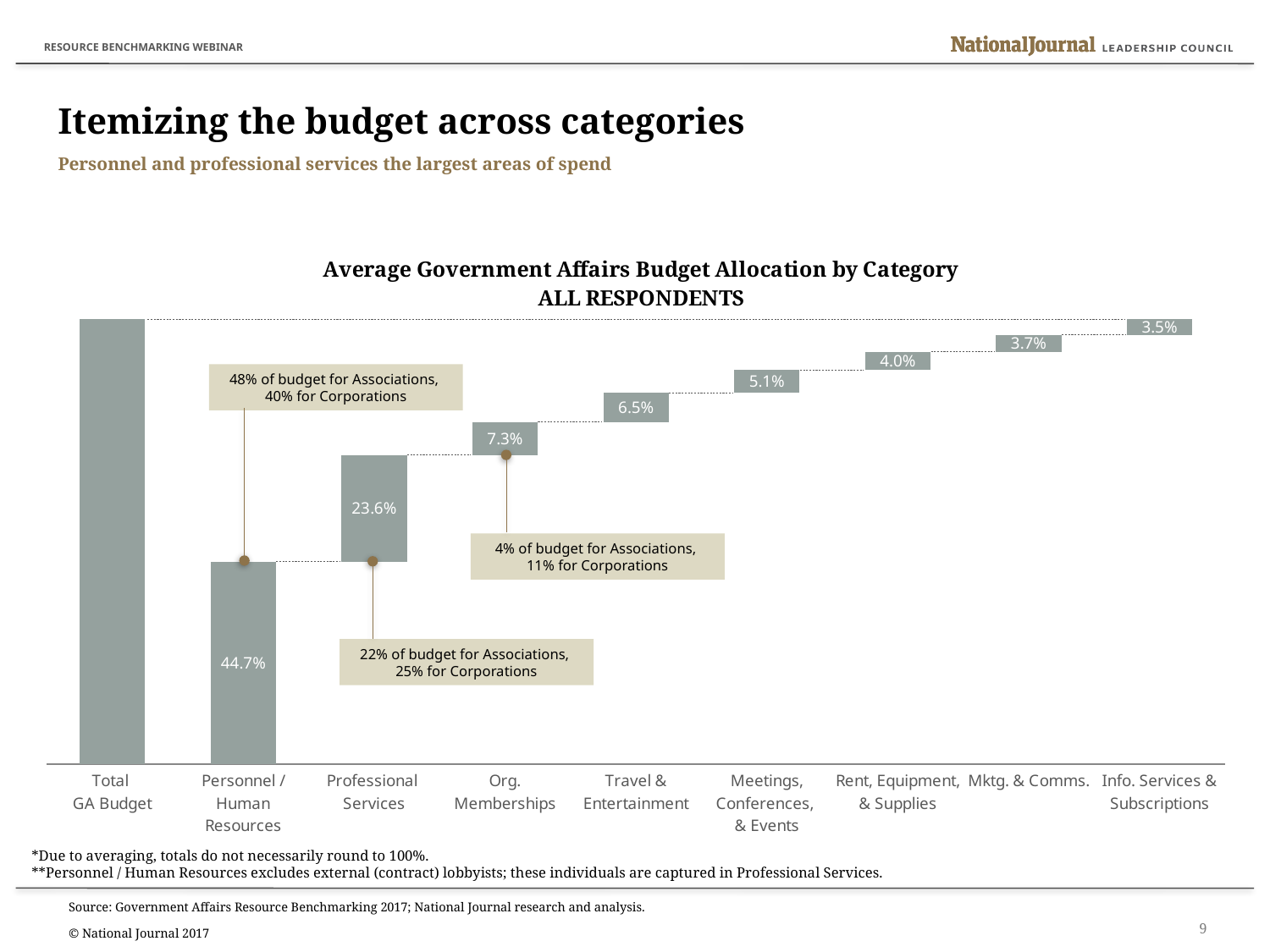
Which labelled category has the lowest value? Info. Services & Subscriptions What is the value for Org. Memberships? 7.3% What is the value for Professional Services? 23.6% How many categories are shown along the x axis, including Total GA Budget? 9 According to the callout, what share of budget do Associations spend on Personnel / Human Resources? 48% Which labelled category has the highest value? Personnel / Human Resources What is the value for Info. Services & Subscriptions? 3.5% What is the value for Personnel / Human Resources? 44.7% What is the title of the chart? Average Government Affairs Budget Allocation by Category ALL RESPONDENTS What is the difference between the values for Personnel / Human Resources and Professional Services? 21.1% Which is larger, the value for Travel & Entertainment or the value for Rent, Equipment & Supplies? Travel & Entertainment What is the value for Meetings, Conferences, & Events? 5.1%